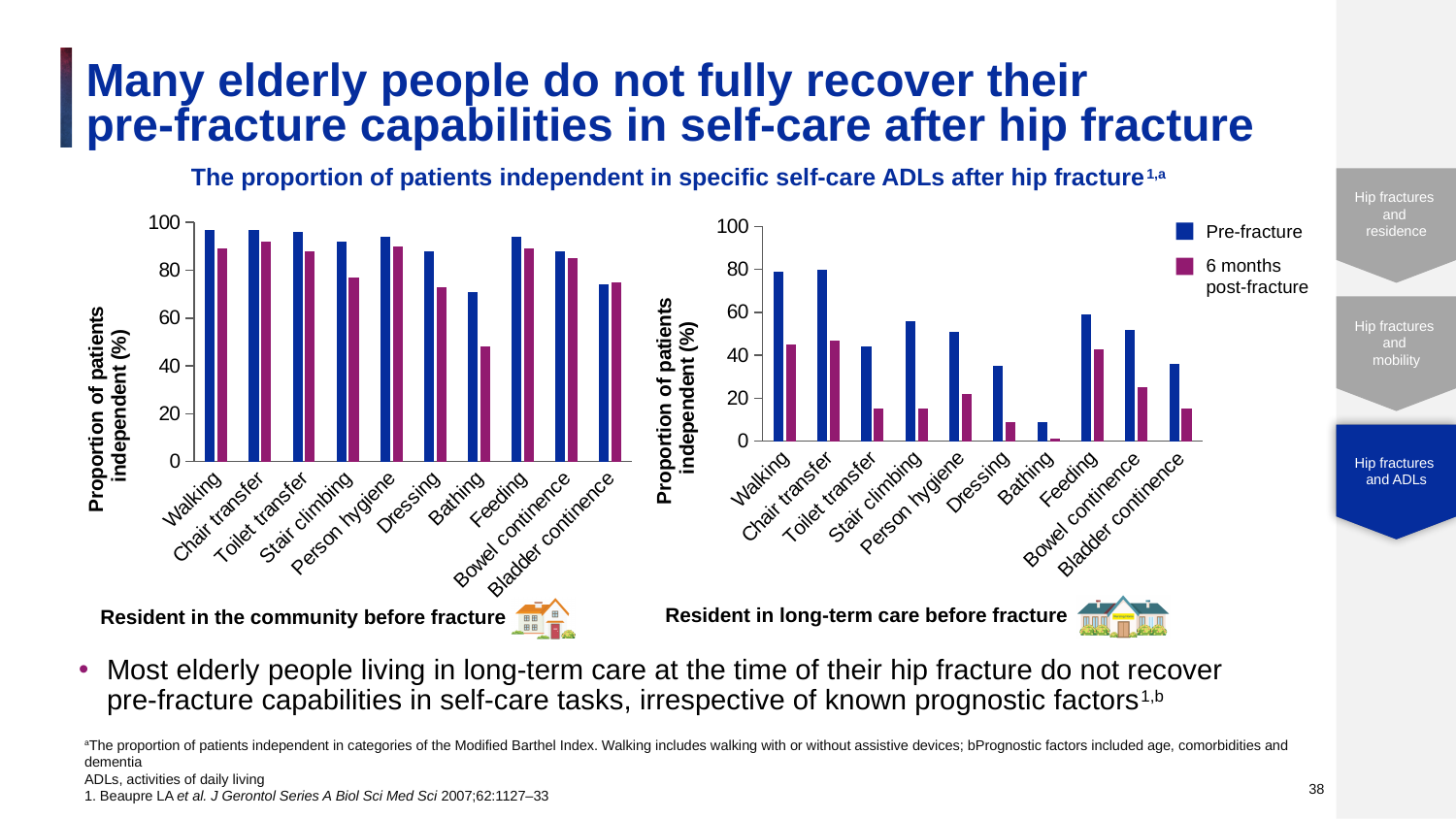
How many series does the legend list for the charts? 2 In the 'Resident in long-term care before fracture' chart, is the pre-fracture value for Walking greater or less than 60? greater In the 'Resident in the community before fracture' chart, which is larger: the 6 months post-fracture value for Stair climbing or for Bathing? Stair climbing In the 'Resident in long-term care before fracture' chart, which is larger: the pre-fracture value for Feeding or the pre-fracture value for Dressing? Feeding In the 'Resident in the community before fracture' chart, is the 6 months post-fracture value for Bathing greater or less than 60? less What colour represents the Pre-fracture series in the legend? blue What is the y-axis label on the 'Resident in the community before fracture' chart? Proportion of patients independent (%) In the 'Resident in the community before fracture' chart, which category has the lowest 6 months post-fracture value? Bathing In the 'Resident in long-term care before fracture' chart, is the 6 months post-fracture value for Dressing greater or less than 20? less In the 'Resident in long-term care before fracture' chart, which category has the lowest pre-fracture value? Bathing How many self-care ADL categories are shown on the x axis of the 'Resident in long-term care before fracture' chart? 10 What kind of chart is used for 'Resident in the community before fracture'? bar chart